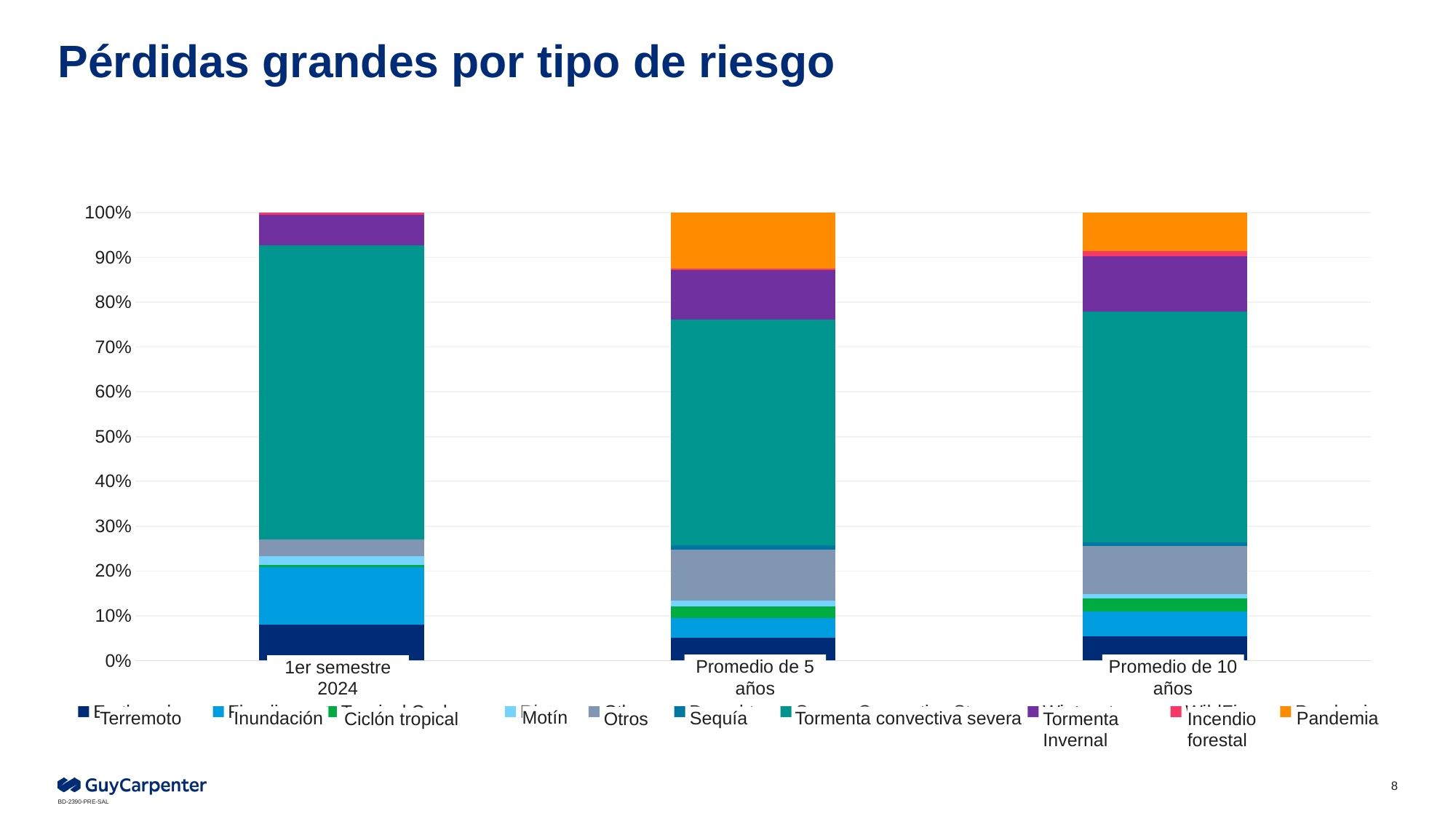
What is the title of the chart on the slide? Pérdidas grandes por tipo de riesgo How many series does the legend list? 10 What colour represents Pandemia in the legend? Orange Is the share of Terremoto in '1er semestre 2024' greater or less than 10%? less Is the share of Pandemia in 'Promedio de 5 años' greater or less than 10%? greater Is the share of Pandemia larger in '1er semestre 2024' or in 'Promedio de 5 años'? Promedio de 5 años Which series takes the largest share of the '1er semestre 2024' bar? Tormenta convectiva severa Is the share of Tormenta convectiva severa larger in '1er semestre 2024' or in 'Promedio de 5 años'? 1er semestre 2024 Is the share of Tormenta convectiva severa in '1er semestre 2024' greater or less than 50%? greater What kind of chart is shown on the slide? Stacked bar chart Which series takes the largest share of the 'Promedio de 10 años' bar? Tormenta convectiva severa How many categories (bars) are shown on the x axis? 3